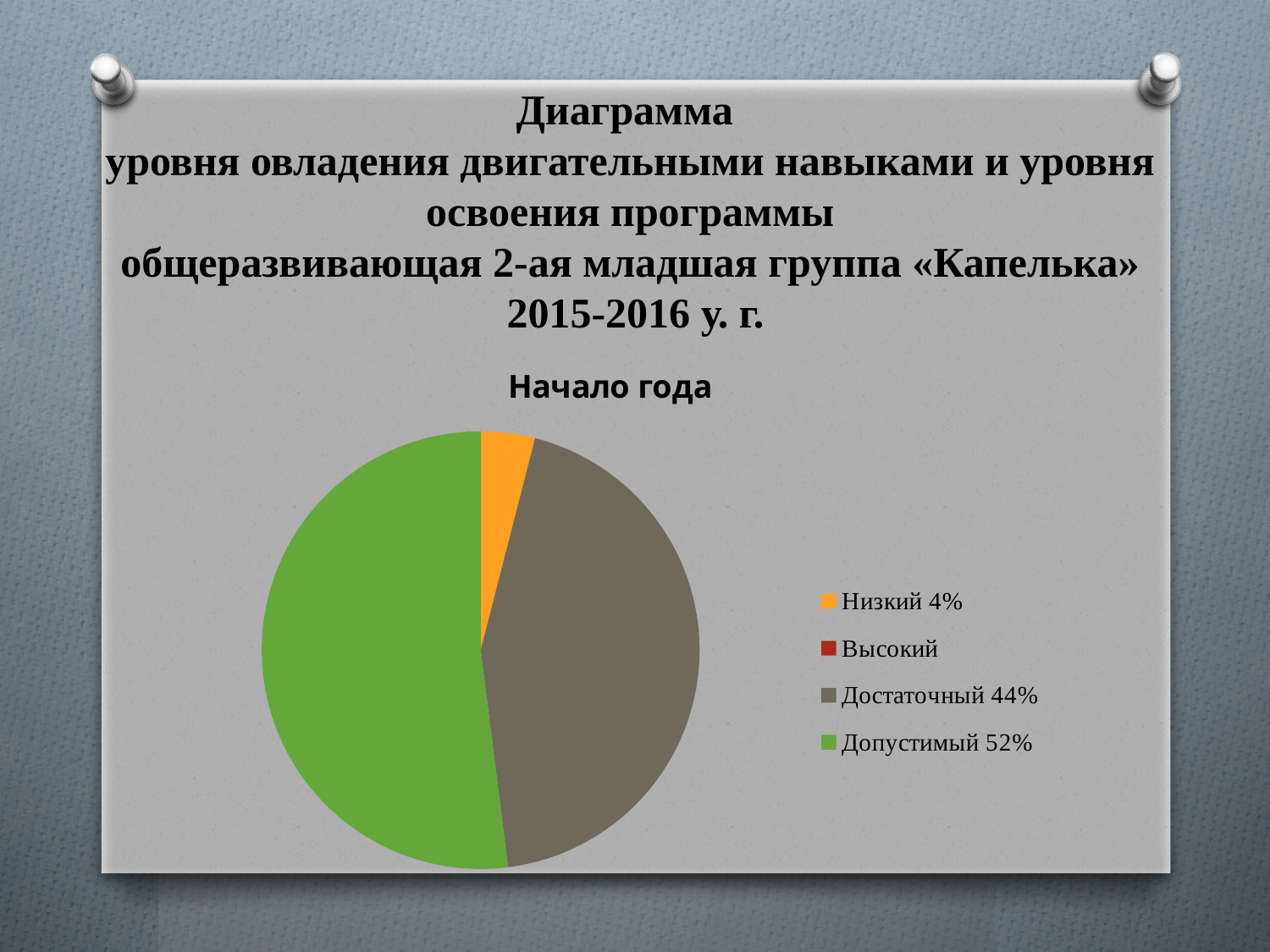
What is the difference between the shares of Достаточный and Низкий? 40% Which category with a visible slice has the smallest share of the pie? Низкий Which is larger, the share of Достаточный or the share of Допустимый? Допустимый What share of the pie does Допустимый have? 52% What share of the pie does Достаточный have? 44% Which category has the largest slice of the pie? Допустимый What share of the pie does Низкий have? 4% How many entries does the legend list? 4 What is the difference between the shares of Допустимый and Достаточный? 8% What colour is the Допустимый slice? green What is the chart's title? Начало года What kind of chart is shown on the slide? pie chart